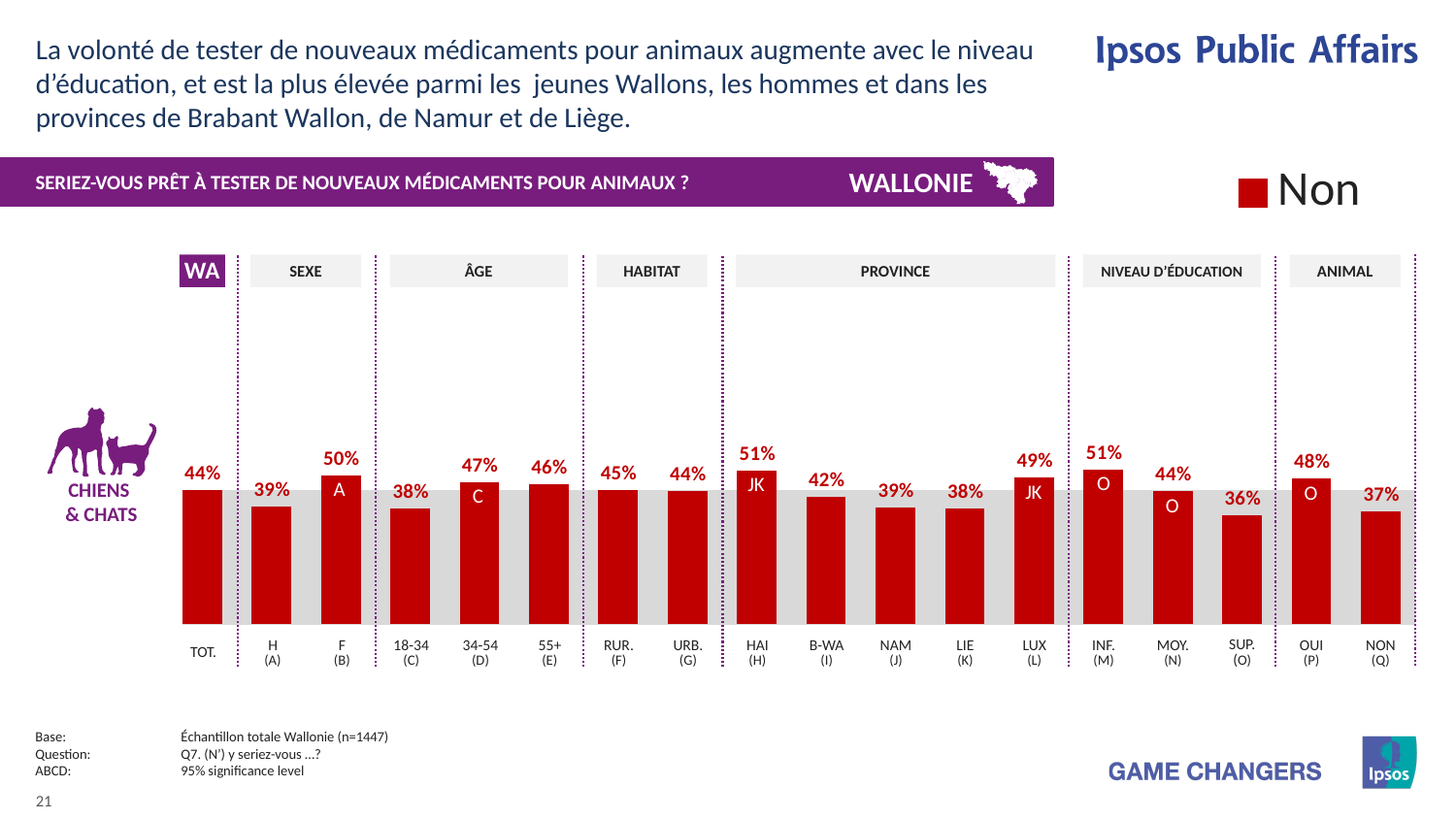
How many bars are plotted on the chart? 18 How many series does the legend list? 1 Which category has the lowest value on the chart? SUP. (O) What is the value for F (B) in the SEXE group? 50% What is the difference between the values for INF. (M) and SUP. (O)? 15% What is the value for TOT. (the WA total)? 44% What kind of chart is shown on the slide? Bar chart What is the difference between the values for F (B) and H (A)? 11% What is the value for LUX (L) in the PROVINCE group? 49% What is the value for the 18-34 (C) age group? 38% Which is larger, the value for RUR. (F) or URB. (G)? RUR. (F) Which province has the highest value in the PROVINCE group? HAI (H)